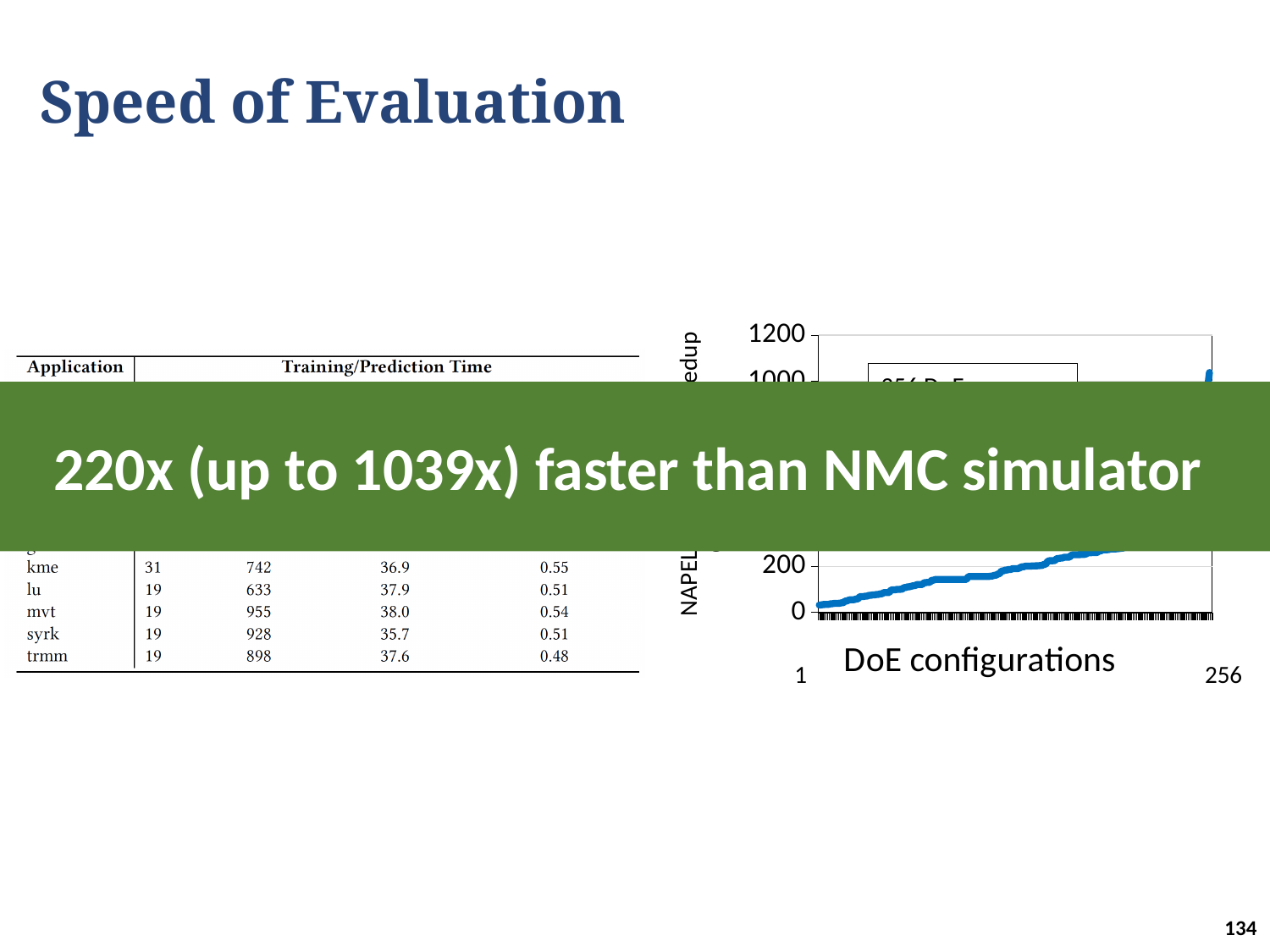
What kind of chart is shown on the right side of the slide? line chart In the chart on the right, do the values rise or fall as you move along the x axis from configuration 1 to 256? rise What is the label of the x axis of the chart on the right? DoE configurations In the chart on the right, is the value for the first DoE configuration greater or less than 200? less What is the highest tick value shown on the y axis of the chart on the right? 1200 What is the last x-axis value shown on the chart on the right? 256 What is the first x-axis value shown on the chart on the right? 1